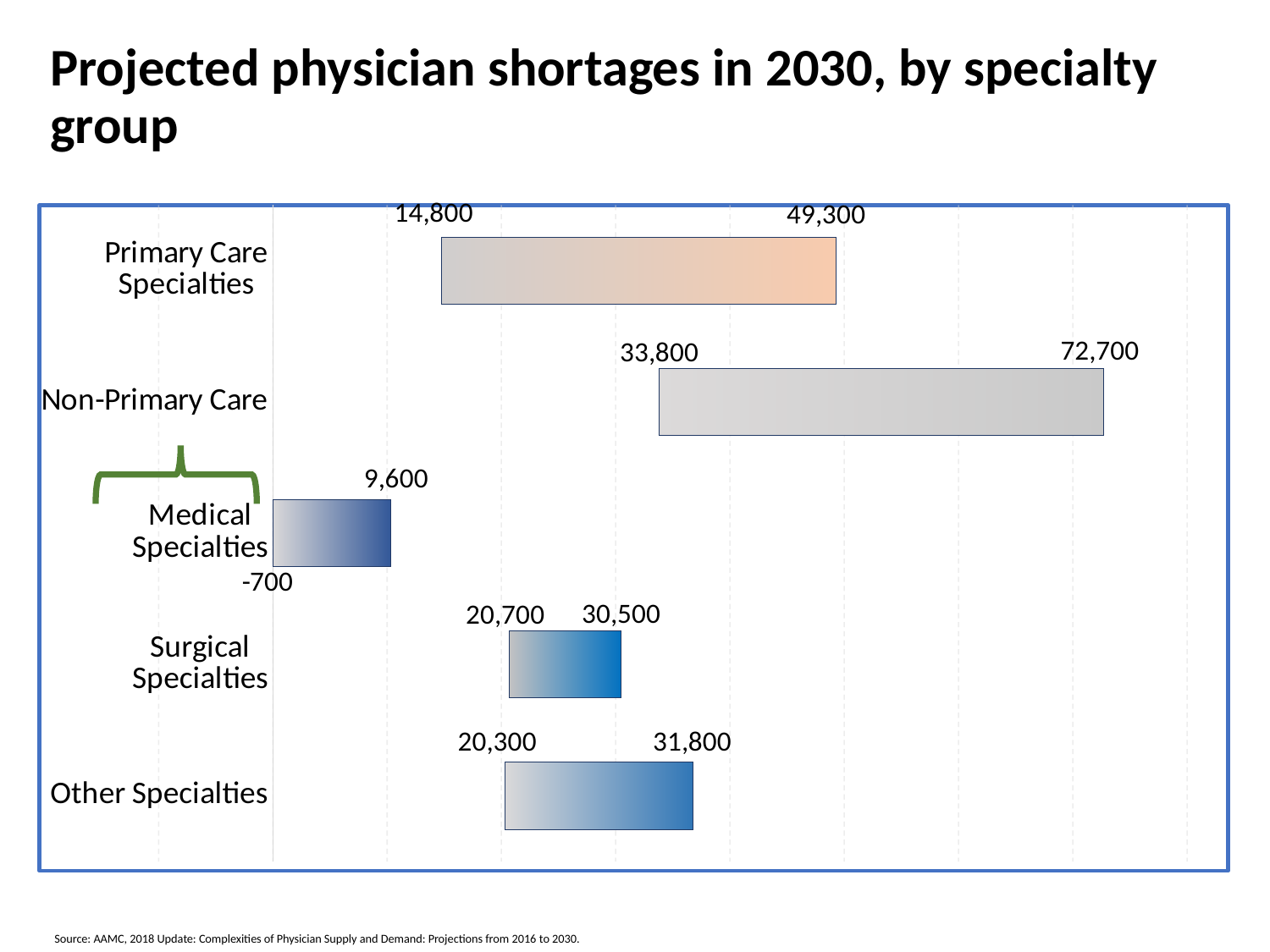
What is the lower end of the projected shortage range for Non-Primary Care? 33,800 Which has a larger upper-end projected shortage, Surgical Specialties or Other Specialties? Other Specialties What is the difference between the upper and lower ends of the projected shortage range for Primary Care Specialties? 34,500 What kind of chart is shown on the slide? Bar chart What is the upper end of the projected shortage range for Primary Care Specialties? 49,300 Which specialty group has the lowest lower-end projected shortage? Medical Specialties What is the lower end of the projected shortage range for Medical Specialties? -700 What is the lower end of the projected shortage range for Other Specialties? 20,300 What is the difference between the upper and lower ends of the projected shortage range for Non-Primary Care? 38,900 How many specialty groups are shown in the chart? 5 Which specialty group has the highest upper-end projected shortage? Non-Primary Care What is the upper end of the projected shortage range for Surgical Specialties? 30,500